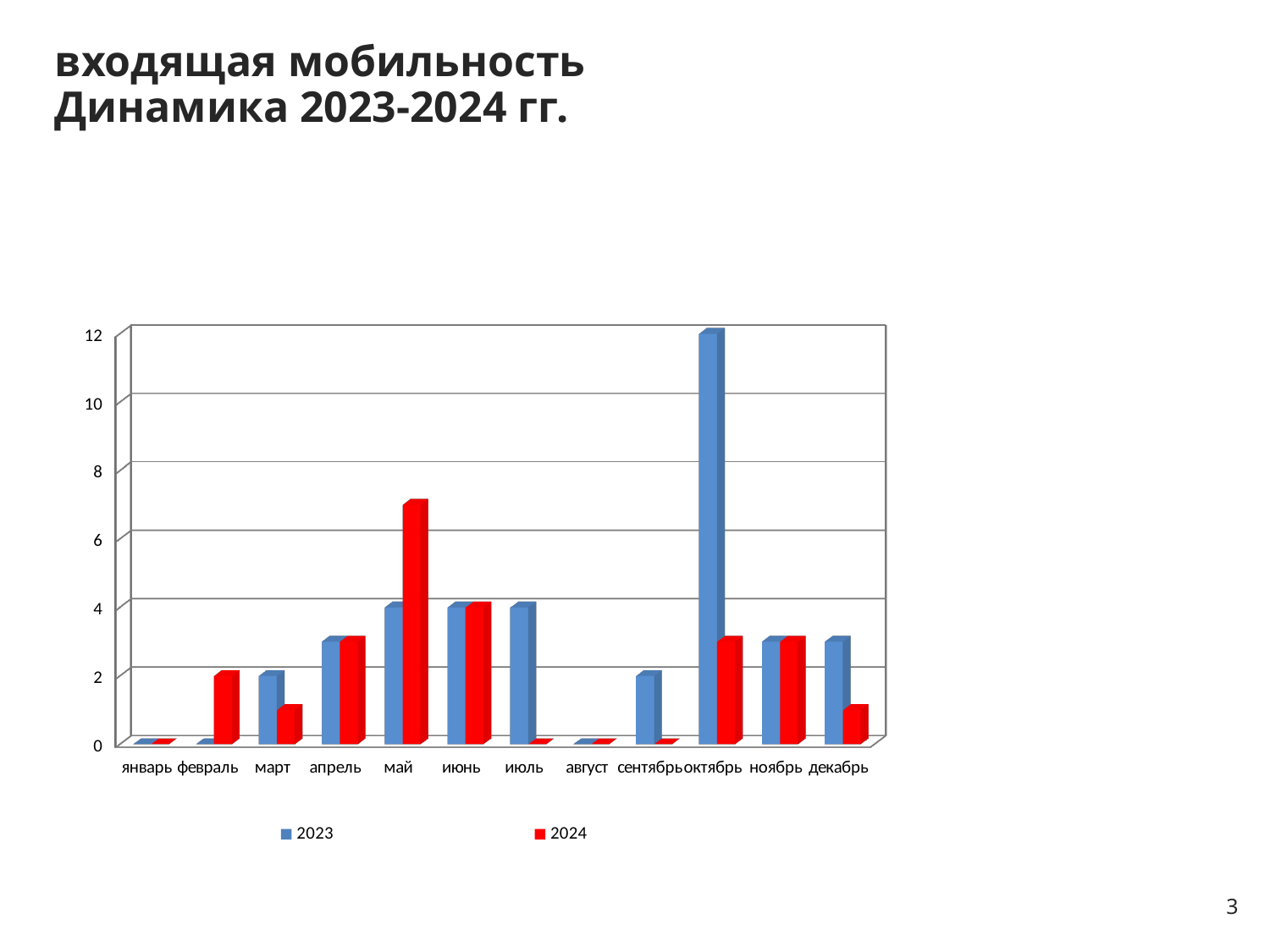
What is the 2023 value for октябрь? 12 In which month is the 2023 value highest? октябрь What colour represents the 2024 series in the legend? red For май, which series has the larger value, 2023 or 2024? 2024 What is the 2024 value for июль? 0 Is the 2024 value for май greater or less than 6? greater Is the 2024 value for октябрь greater or less than 4? less For октябрь, which series has the larger value, 2023 or 2024? 2023 In which month is the 2024 value highest? май How many series does the legend list? 2 What kind of chart is shown on the slide? bar chart How many months are shown on the x axis? 12